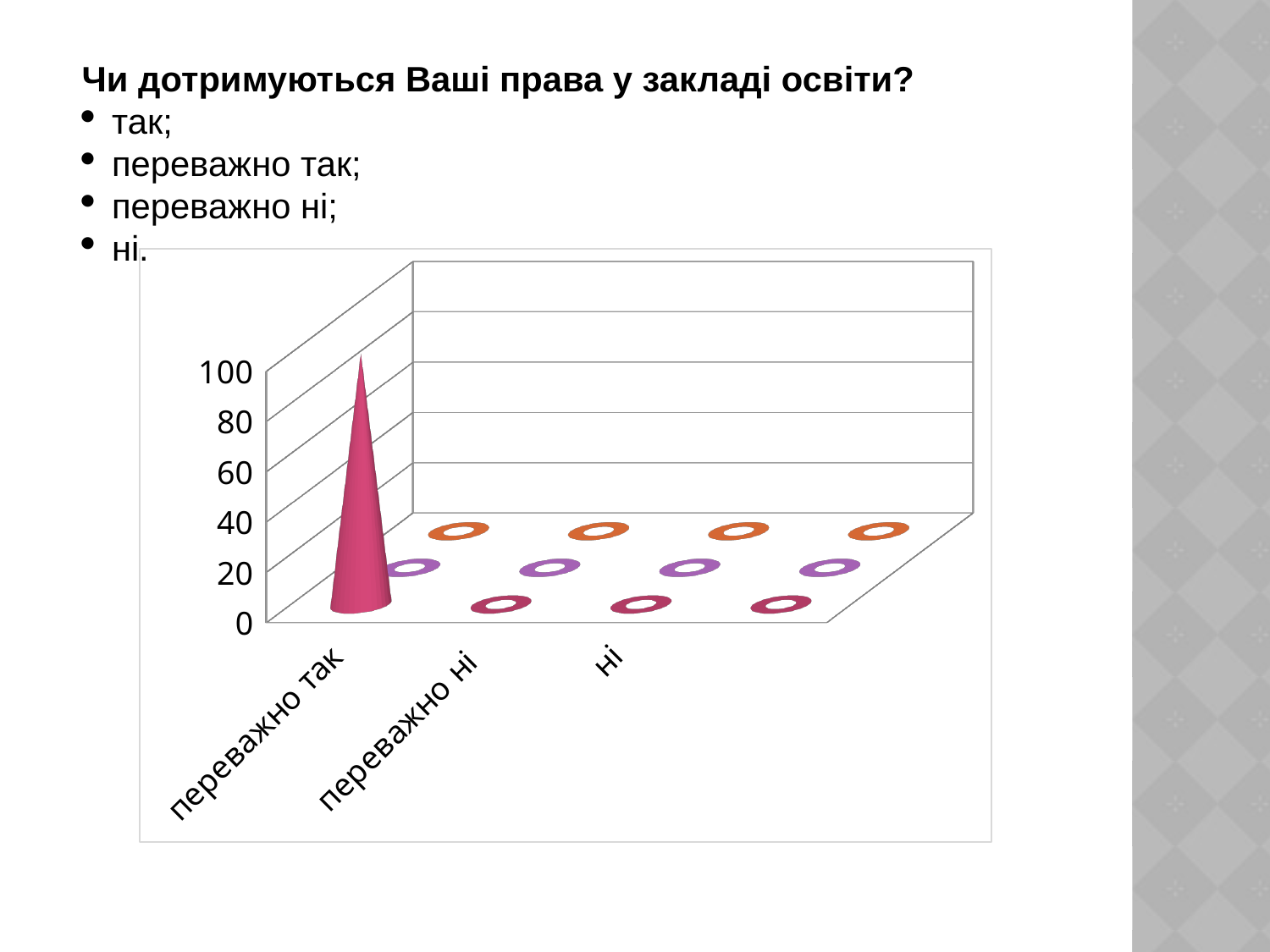
Is the value of the single tall cone in the chart greater or less than 80? greater What kind of chart is shown on the slide? bar chart Is the value for "переважно ні" greater or less than 20? less What is the highest value labelled on the vertical axis of the chart? 100 Is the value for "ні" greater or less than 20? less What is the interval between consecutive tick labels on the vertical axis? 20